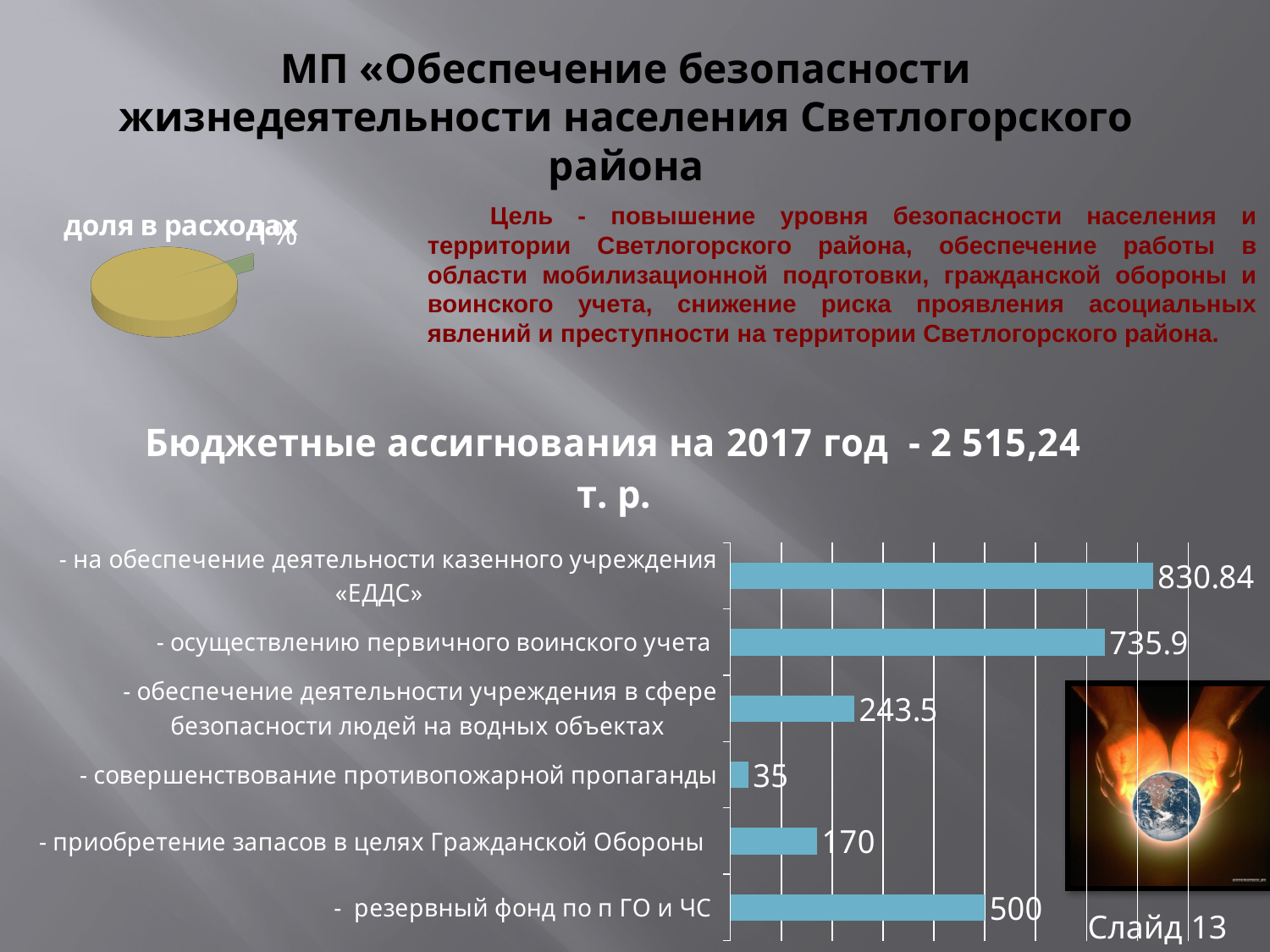
On the lower bar chart, what is the value for «- совершенствование противопожарной пропаганды»? 35 What kind of chart is the small chart labelled «доля в расходах» at the top left of the slide? pie chart On the lower bar chart, what is the value for «- резервный фонд по п ГО и ЧС»? 500 How many categories are shown on the lower bar chart? 6 On the lower bar chart, which is larger: the value for «- осуществлению первичного воинского учета» or for «- резервный фонд по п ГО и ЧС»? - осуществлению первичного воинского учета On the lower bar chart, which category has the highest value? - на обеспечение деятельности казенного учреждения «ЕДДС» On the lower bar chart, what is the value for «- на обеспечение деятельности казенного учреждения «ЕДДС»»? 830.84 On the lower bar chart, what is the difference between the values for «- резервный фонд по п ГО и ЧС» and «- приобретение запасов в целях Гражданской Обороны»? 330 On the lower bar chart, what is the value for «- осуществлению первичного воинского учета»? 735.9 On the lower bar chart, what is the value for «- приобретение запасов в целях Гражданской Обороны»? 170 On the lower bar chart, which category has the lowest value? - совершенствование противопожарной пропаганды On the lower bar chart, what is the value for «- обеспечение деятельности учреждения в сфере безопасности людей на водных объектах»? 243.5